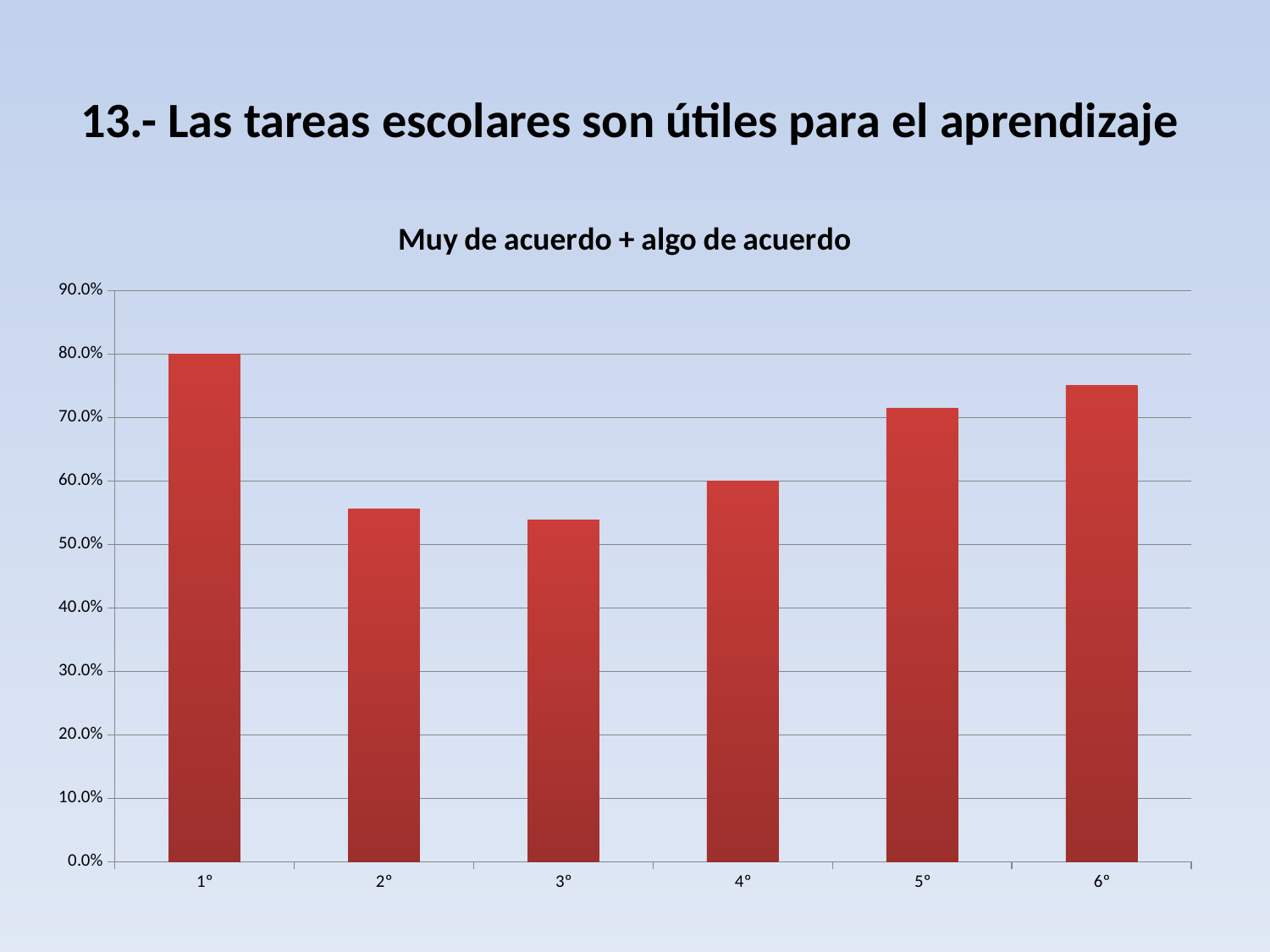
Is the value for 5° greater or less than 70.0%? greater Is the value for 3° greater or less than 50.0%? greater Is the value for 6° greater or less than 80.0%? less What kind of chart is shown on the slide? bar chart What is the title of the chart? Muy de acuerdo + algo de acuerdo How many categories are plotted on the x axis? 6 Which is larger, the value for 1° or the value for 6°? 1° Which category has the highest value? 1° What is the value for 1°? 80.0% What is the value for 4°? 60.0% Which is larger, the value for 4° or the value for 5°? 5°